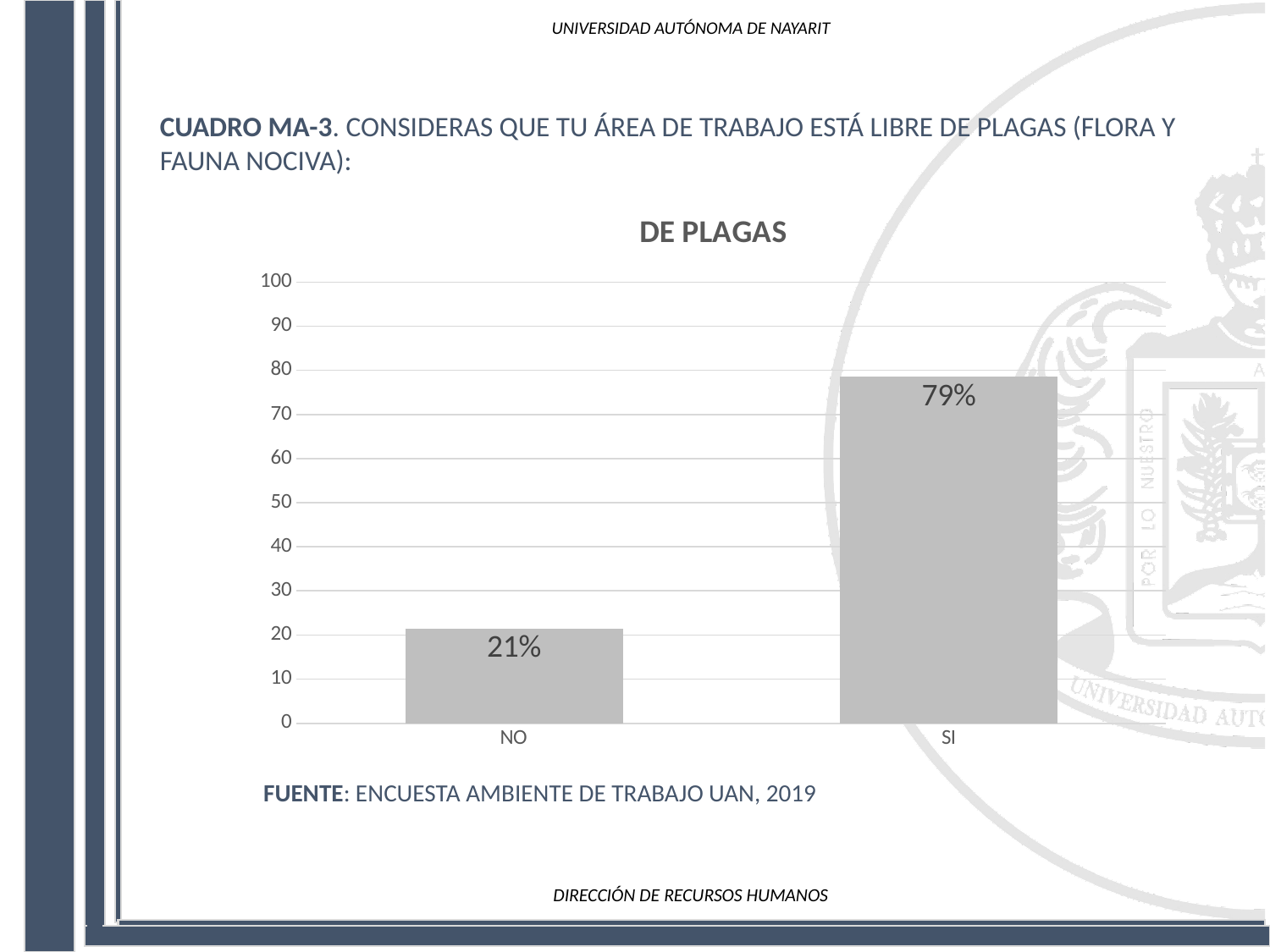
Is the value for SI greater or less than 70? greater Which category has the highest value? SI What is the value for NO? 21% What is the difference between the values for SI and NO? 58% What kind of chart is shown? bar chart How many categories are shown on the x axis? 2 What is the highest value shown on the vertical axis? 100 Which category has the lowest value? NO Is the value for NO greater or less than 30? less What is the title of the chart? DE PLAGAS Which is larger, the value for NO or the value for SI? SI What is the value for SI? 79%